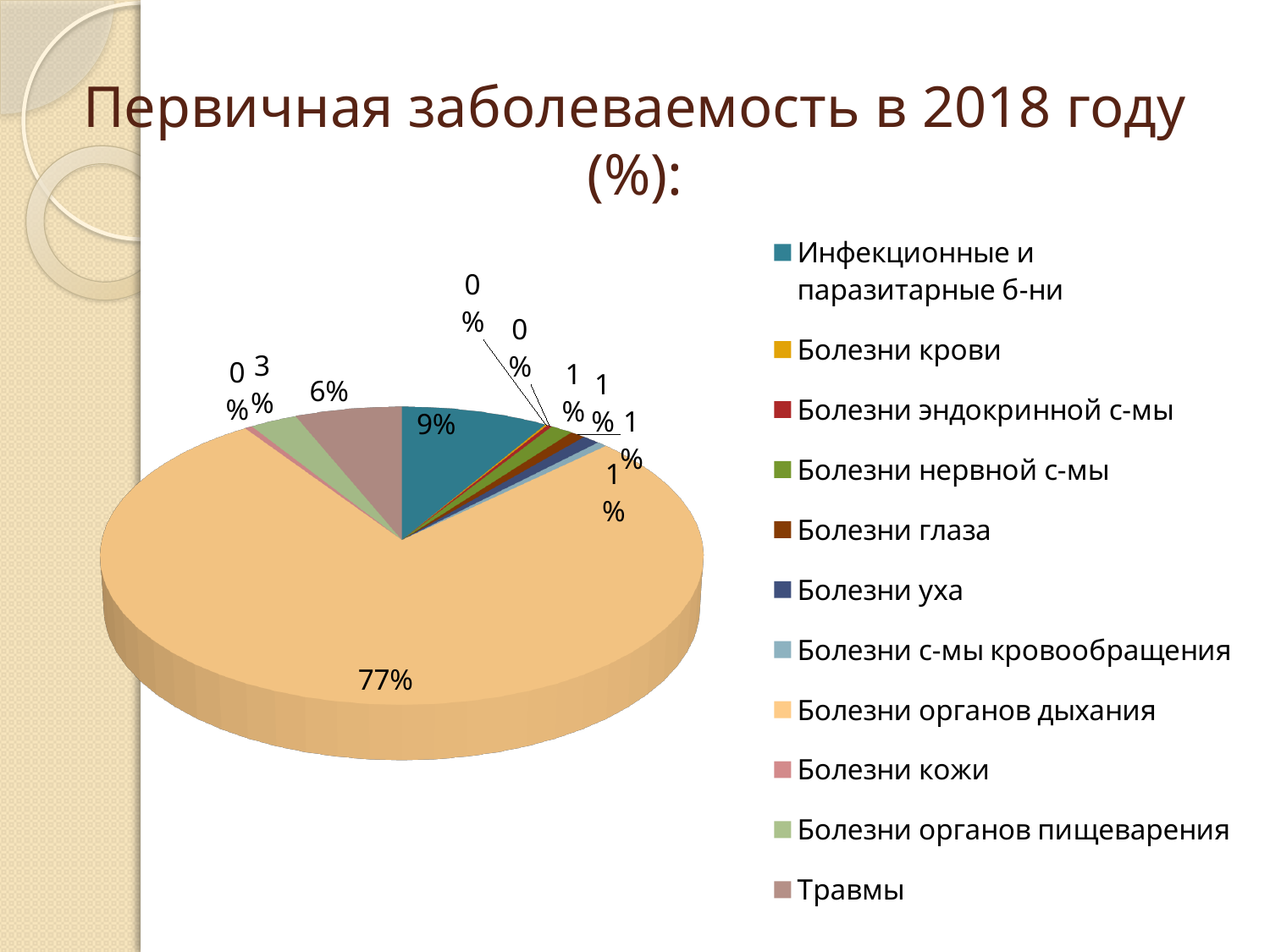
What colour is the slice for Болезни органов дыхания? light orange Which category has the largest slice of the pie? Болезни органов дыхания What is the value for Инфекционные и паразитарные б-ни? 9% What is the title of the chart? Первичная заболеваемость в 2018 году (%): What type of chart is shown on the slide? pie chart What share of the pie is Болезни органов дыхания? 77% Which is larger, Травмы or Болезни органов пищеварения? Травмы Which is larger, Инфекционные и паразитарные б-ни or Травмы? Инфекционные и паразитарные б-ни What is the difference in percentage points between Болезни органов дыхания and Инфекционные и паразитарные б-ни? 68 What is the value for Болезни органов пищеварения? 3% What is the value for Травмы? 6% How many categories does the legend list? 11